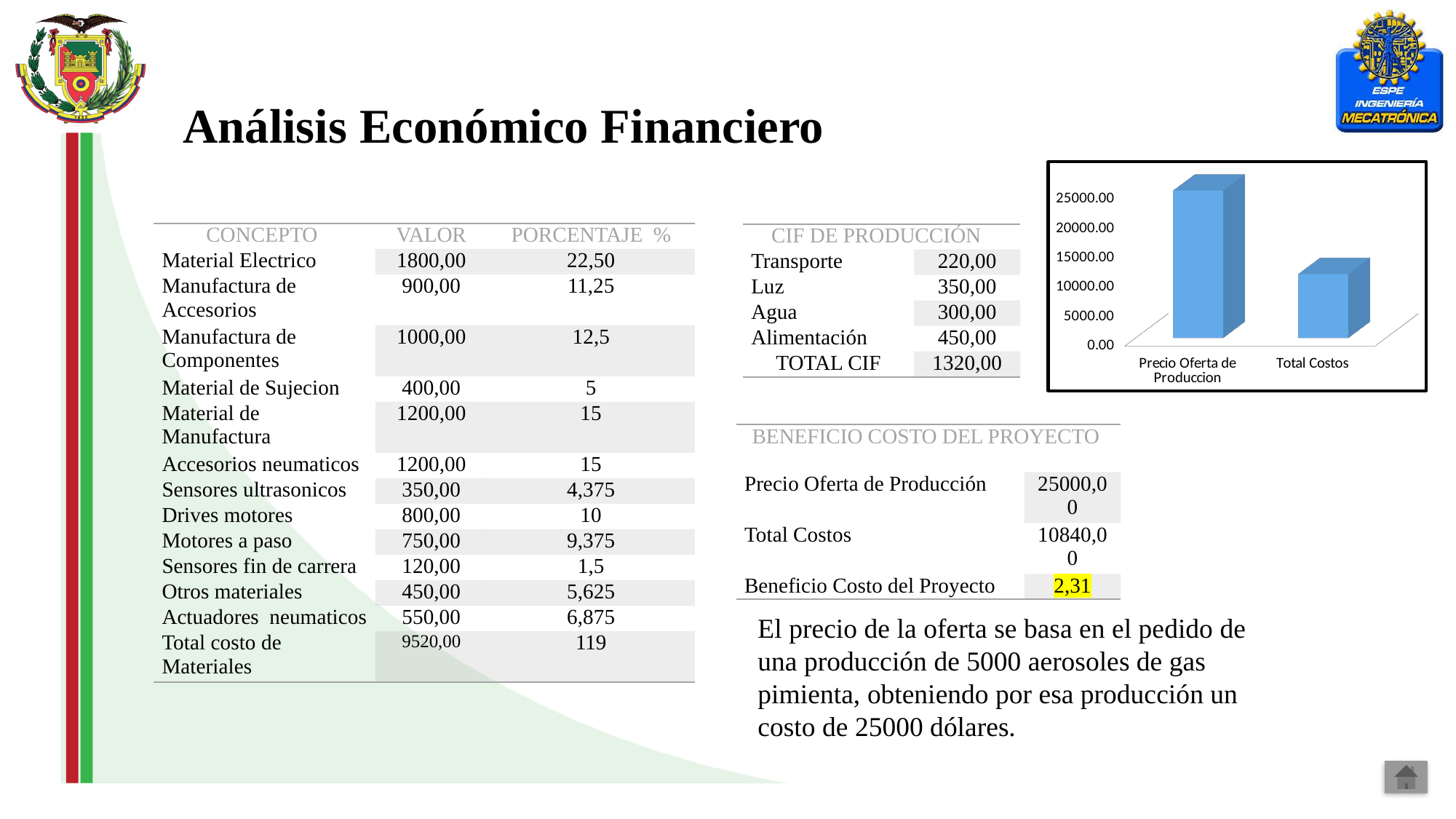
Which is larger in the chart, Precio Oferta de Produccion or Total Costos? Precio Oferta de Produccion How many bars does the chart show? 2 Is the value for Precio Oferta de Produccion greater or less than 15000.00? greater Is the value for Total Costos greater or less than 5000.00? greater Is the value for Precio Oferta de Produccion greater or less than 20000.00? greater What kind of chart is shown on the slide? bar chart What is the highest value shown on the chart's vertical axis? 25000.00 What colour are the bars in the chart? blue Which category has the lowest bar in the chart? Total Costos Which category has the highest bar in the chart? Precio Oferta de Produccion